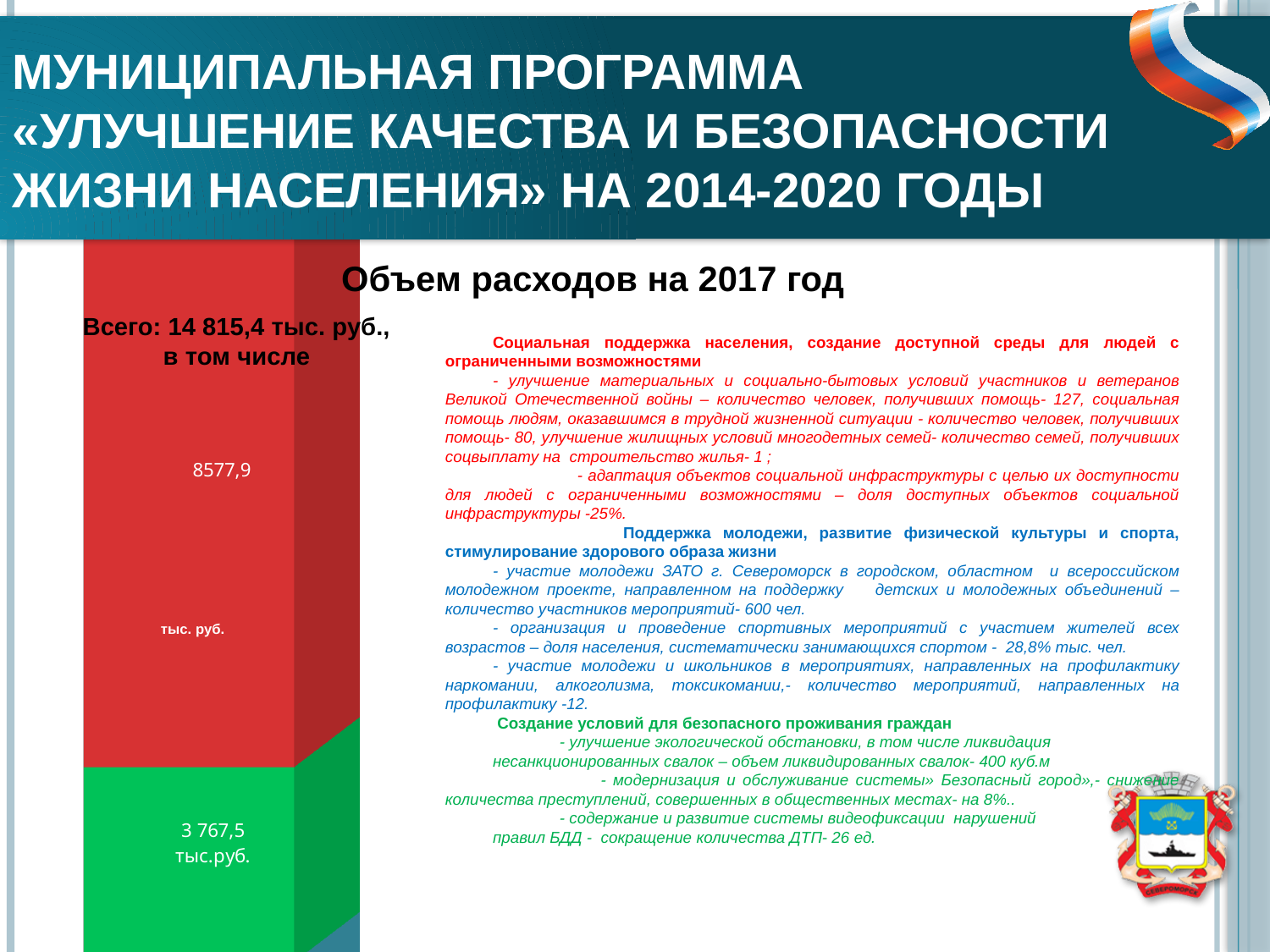
In what unit are the values on the bar expressed? тыс. руб. How many segments of the bar have a value label printed on them? 2 Which colour is the segment with the largest printed value? Red What kind of chart is shown on the left of the slide? Stacked bar chart What value is printed on the green segment of the bar? 3 767,5 тыс.руб. Which colour is the segment with the smallest printed value? Green What is the total value of the stacked bar as stated on the slide? 14 815,4 тыс. руб. What is the difference between the red segment (8577,9) and the green segment (3 767,5)? 4 810,4 What is the title of the chart section on the slide? Объем расходов на 2017 год Which segment is larger, the red one or the green one? The red one What value is printed on the red segment of the bar? 8577,9